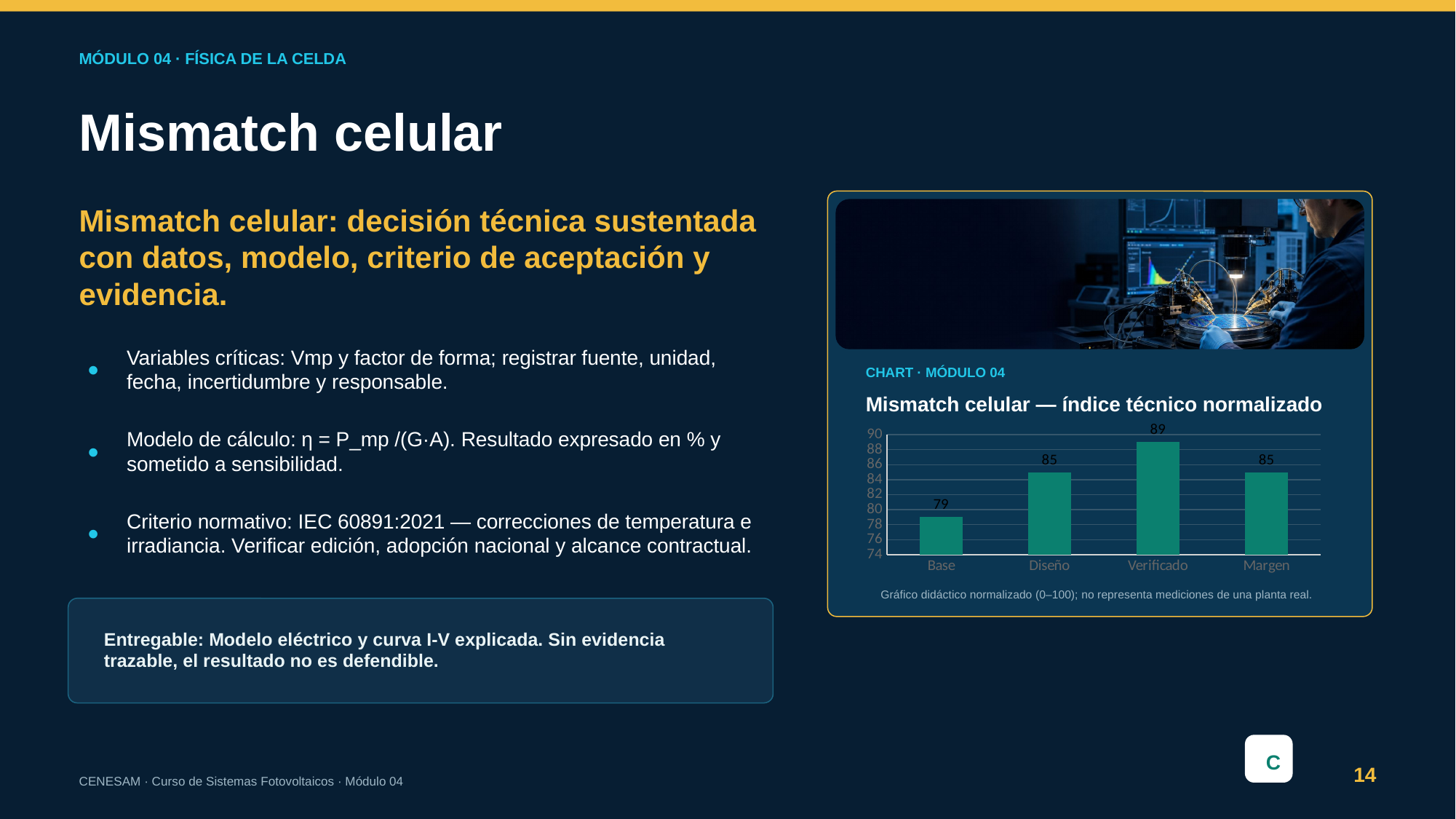
What is the title of the chart on the slide? Mismatch celular — índice técnico normalizado Which category has the lowest value in the chart? Base What is the difference between the values for Verificado and Base? 10 What is the value for Verificado in the chart? 89 What is the value for Base in the chart? 79 Is the value for Base greater or less than 80? less How many categories are shown on the x axis of the chart? 4 What kind of chart is shown on the slide? bar chart Which is larger, the value for Verificado or the value for Margen? Verificado Which category has the highest value in the chart? Verificado What is the difference between the values for Diseño and Base? 6 What is the value for Diseño in the chart? 85